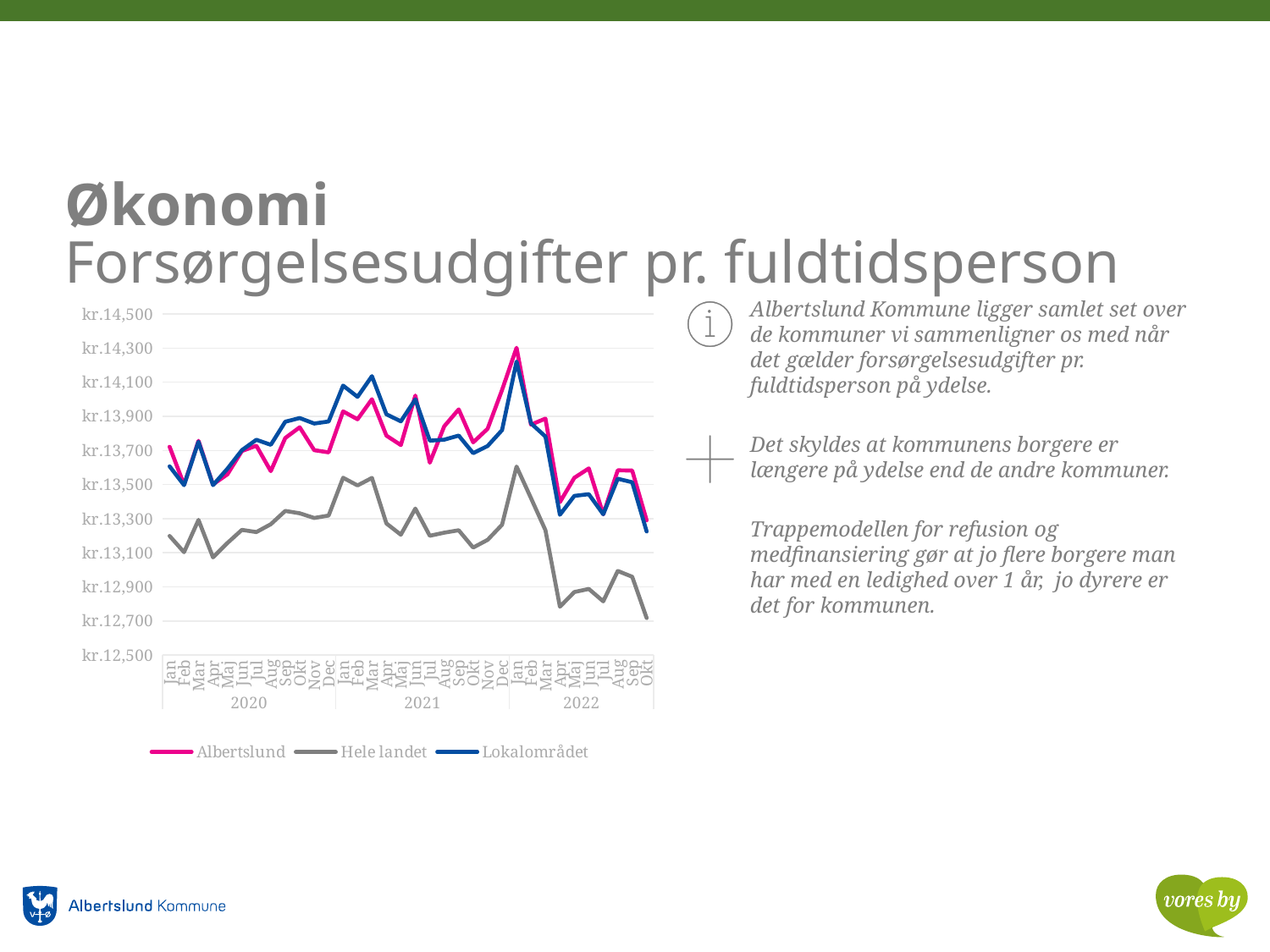
Is the value for Hele landet in Okt 2022 greater or less than kr.12,900? less Does the Hele landet line rise or fall from Jan 2022 to Okt 2022? Fall What is the highest value shown on the y axis? kr.14,500 Is the value for Albertslund in Jan 2022 greater or less than kr.14,100? greater How many years are shown on the x axis? 3 How many series does the chart legend list? 3 Which colour is used for the Albertslund line? Pink In Jan 2022, which is larger: the value for Albertslund or the value for Hele landet? Albertslund Which series are listed in the chart legend? Albertslund, Hele landet, Lokalområdet What kind of chart is shown on the slide? Line chart Which series has the lowest values across the whole period? Hele landet Is the value for Hele landet in Jan 2020 greater or less than kr.13,500? less